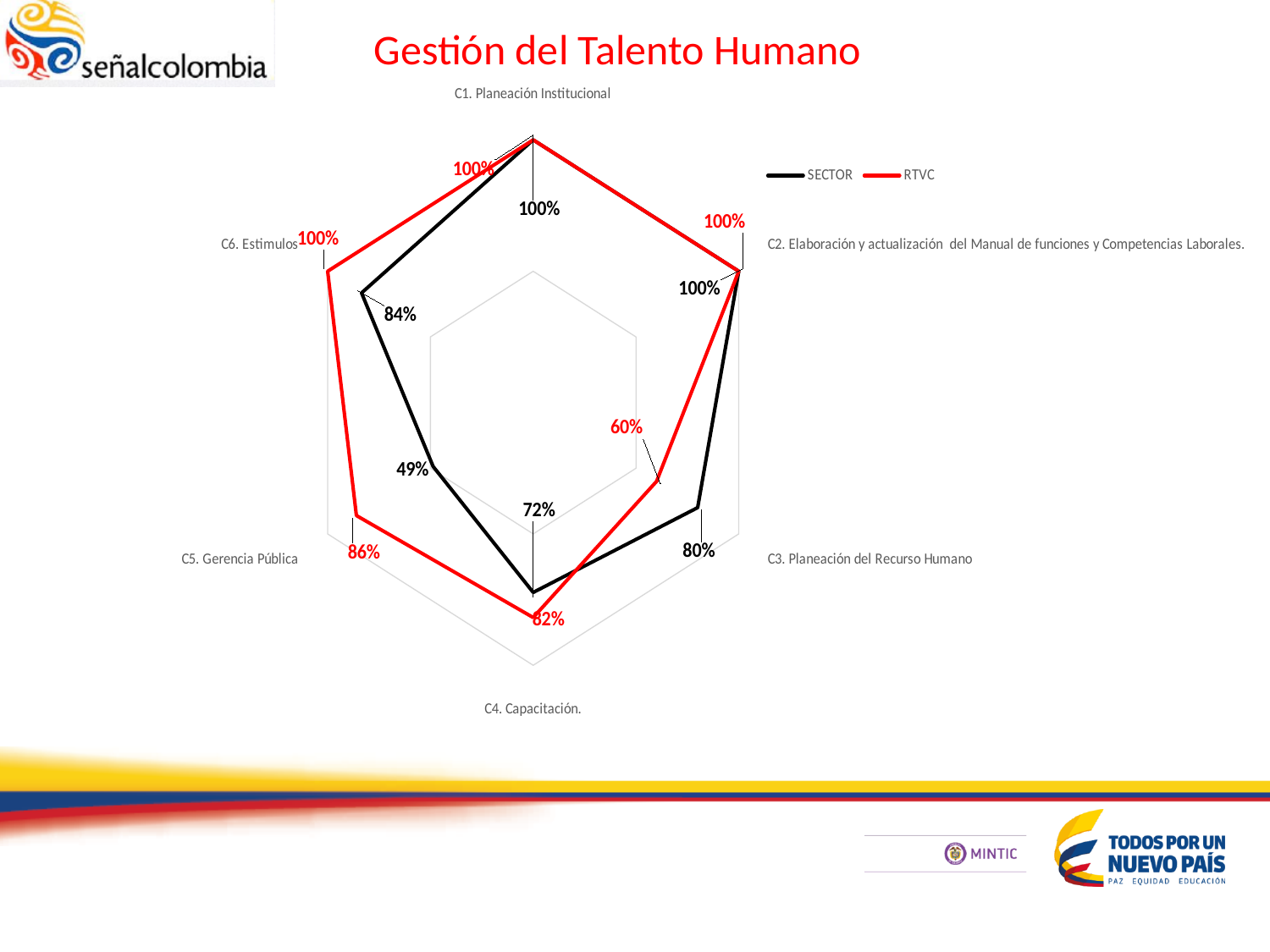
What is the RTVC value for C4. Capacitación? 82% For C3. Planeación del Recurso Humano, which series has the larger value, SECTOR or RTVC? SECTOR How many categories (axes) does the radar chart have? 6 What is the RTVC value for C3. Planeación del Recurso Humano? 60% Which colour is used for the RTVC series? Red Which category has the lowest RTVC value? C3. Planeación del Recurso Humano How many series does the legend list? 2 What is the difference between the RTVC and SECTOR values for C5. Gerencia Pública? 37% What is the SECTOR value for C5. Gerencia Pública? 49% Which category has the lowest SECTOR value? C5. Gerencia Pública What kind of chart is shown on the slide? Radar chart What is the SECTOR value for C6. Estímulos? 84%